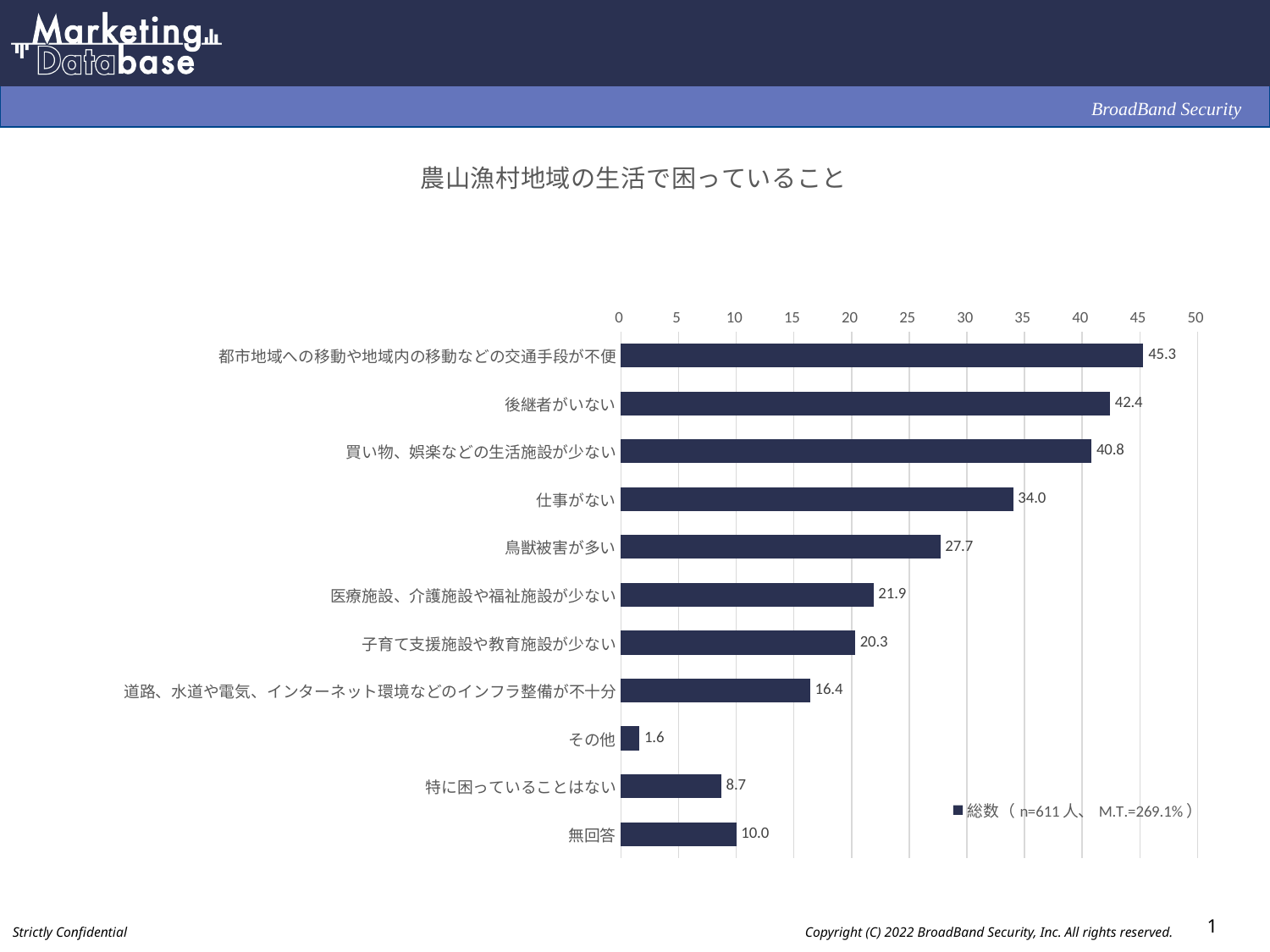
What kind of chart is shown on the slide? bar chart Which category has the lowest value? その他 Is the value for 特に困っていることはない greater or less than 10? less Which category has the highest value? 都市地域への移動や地域内の移動などの交通手段が不便 What is the value for 無回答? 10.0 How many categories are shown in the chart? 11 What is the difference between the values for 後継者がいない and 買い物、娯楽などの生活施設が少ない? 1.6 What is the value for 仕事がない? 34.0 How many series does the legend list? 1 What is the title of the chart? 農山漁村地域の生活で困っていること Which is larger, the value for 医療施設、介護施設や福祉施設が少ない or the value for 子育て支援施設や教育施設が少ない? 医療施設、介護施設や福祉施設が少ない What is the value for 鳥獣被害が多い? 27.7